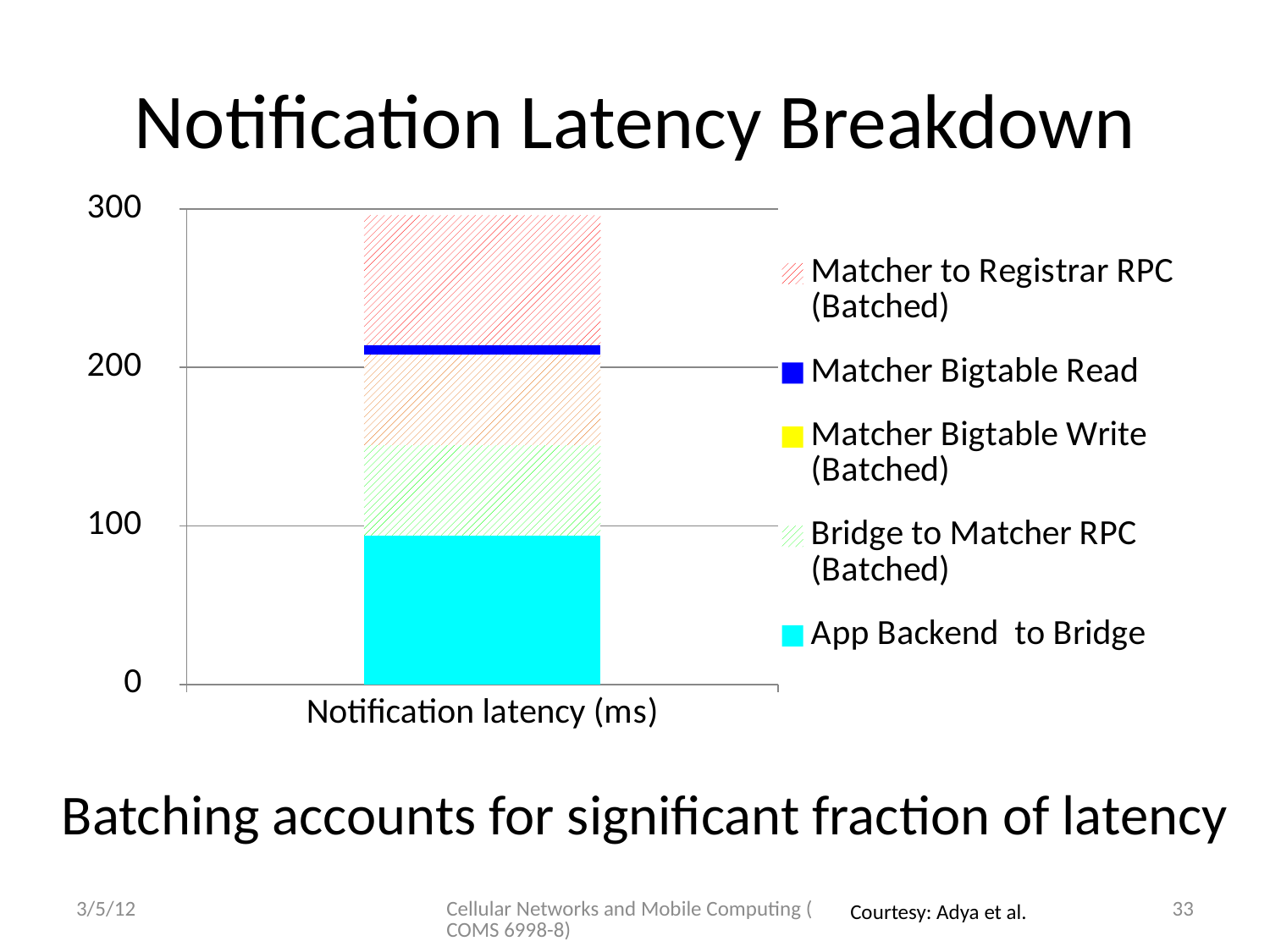
What kind of chart is shown on the slide? Stacked bar chart Which series forms the bottom segment of the stacked bar? App Backend to Bridge Which is larger, the App Backend to Bridge segment or the Matcher Bigtable Read segment? App Backend to Bridge Is the value for App Backend to Bridge greater or less than 100? less Which is larger, the Bridge to Matcher RPC (Batched) segment or the Matcher Bigtable Read segment? Bridge to Matcher RPC (Batched) Is the top of the stacked bar above or below the 100 gridline? above Is the total height of the stacked bar greater or less than 200? greater What is the label of the category on the x axis? Notification latency (ms) How many series does the legend list? 5 Which is larger, the Matcher to Registrar RPC (Batched) segment or the Bridge to Matcher RPC (Batched) segment? Matcher to Registrar RPC (Batched) How many bars (categories) are plotted on the x axis? 1